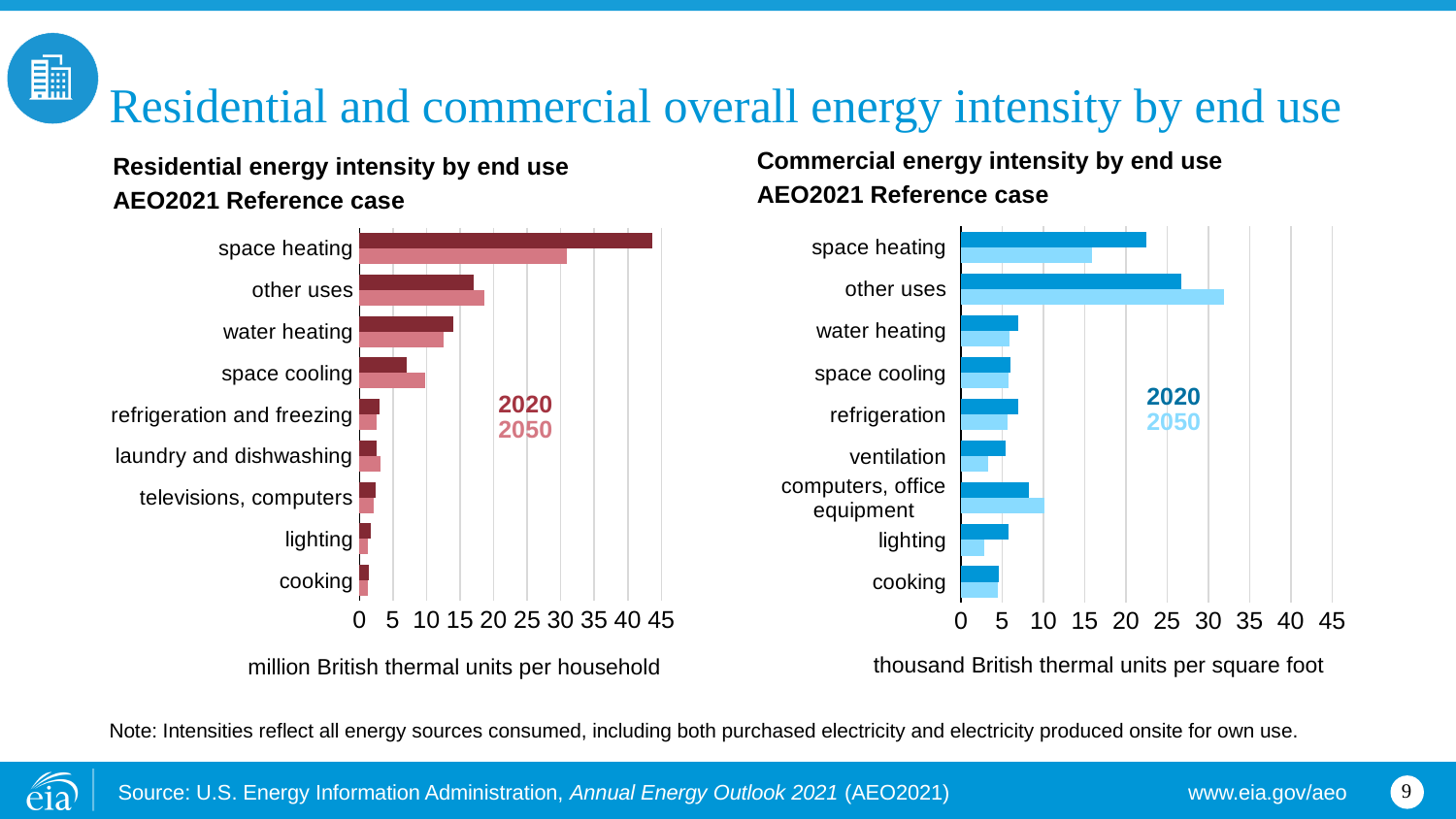
In the Commercial energy intensity by end use chart, which has the larger 2020 value, space heating or other uses? other uses In the Residential energy intensity by end use chart, which is larger for space cooling, the 2020 value or the 2050 value? 2050 In the Commercial energy intensity by end use chart, which end use has the highest value for 2050? other uses In the Residential energy intensity by end use chart, is the 2050 value for space heating greater or less than 35? less What unit is shown on the x axis of the Commercial energy intensity by end use chart? thousand British thermal units per square foot What kind of chart is the Commercial energy intensity by end use chart? bar chart How many series does the legend of the Residential energy intensity by end use chart list? 2 In the Commercial energy intensity by end use chart, is the 2050 value for other uses greater or less than 30? greater In the Residential energy intensity by end use chart, which end use has the highest value for 2020? space heating In the Residential energy intensity by end use chart, is the 2020 value for space heating greater or less than 40? greater How many end-use categories are shown in the Residential energy intensity by end use chart? 9